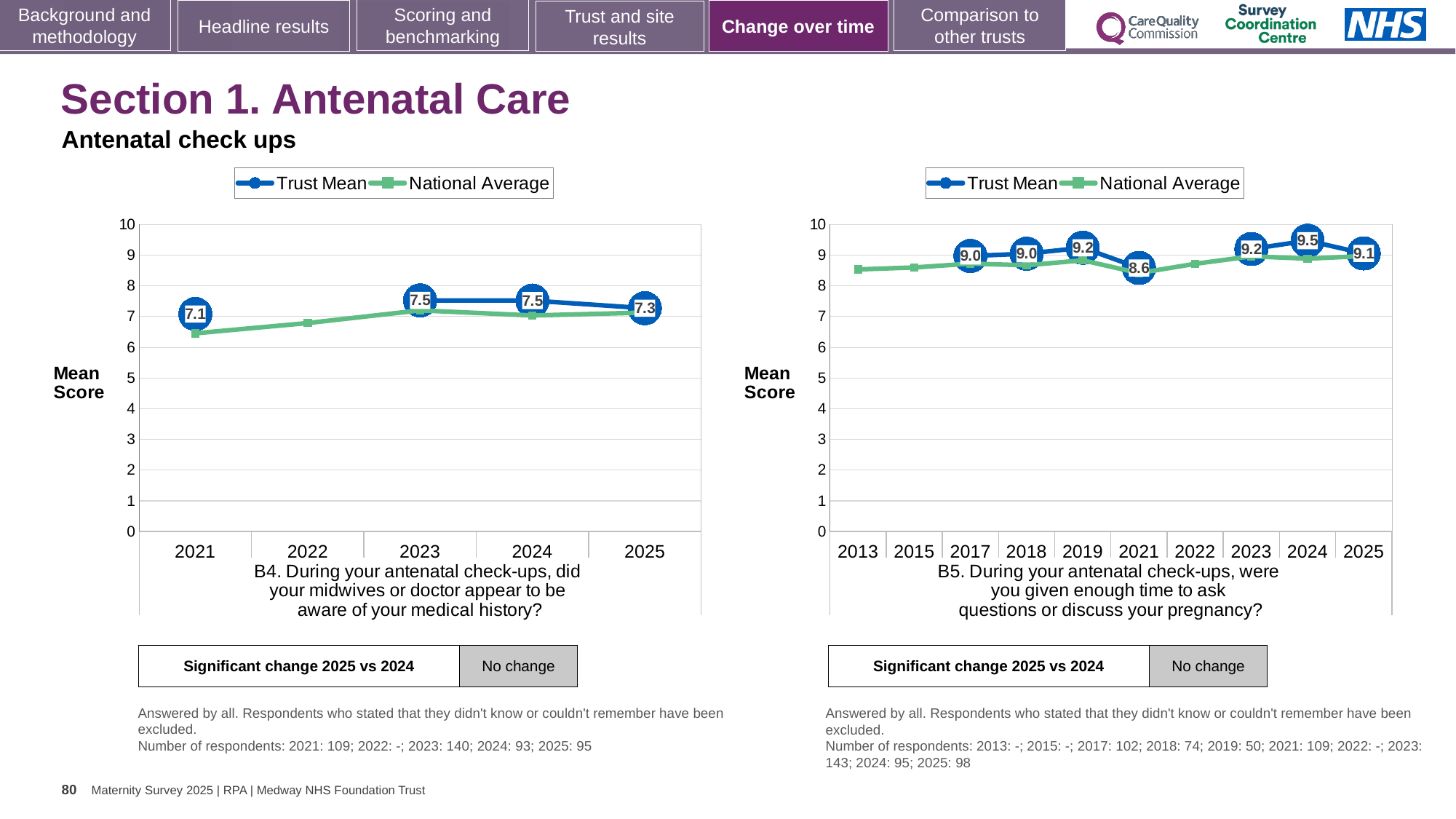
In the left chart (B4), what is the Trust Mean value for 2021? 7.1 In the left chart (B4), is the Trust Mean value for 2023 larger or smaller than the value for 2021? larger In the right chart (B5), which year has the highest Trust Mean value? 2024 In the left chart (B4), what is the result shown for 'Significant change 2025 vs 2024'? No change In the left chart (B4), what is the Trust Mean value for 2025? 7.3 How many years are shown on the x axis of the right chart (B5)? 10 How many series does the legend of the left chart (B4) list? 2 In the right chart (B5), what is the difference between the Trust Mean values for 2024 and 2025? 0.4 In the left chart (B4), is the National Average value for 2021 greater or less than 7? less In the right chart (B5), what is the Trust Mean value for 2021? 8.6 In the right chart (B5), which year has the lowest Trust Mean value? 2021 What kind of chart is the left chart (B4)? line chart